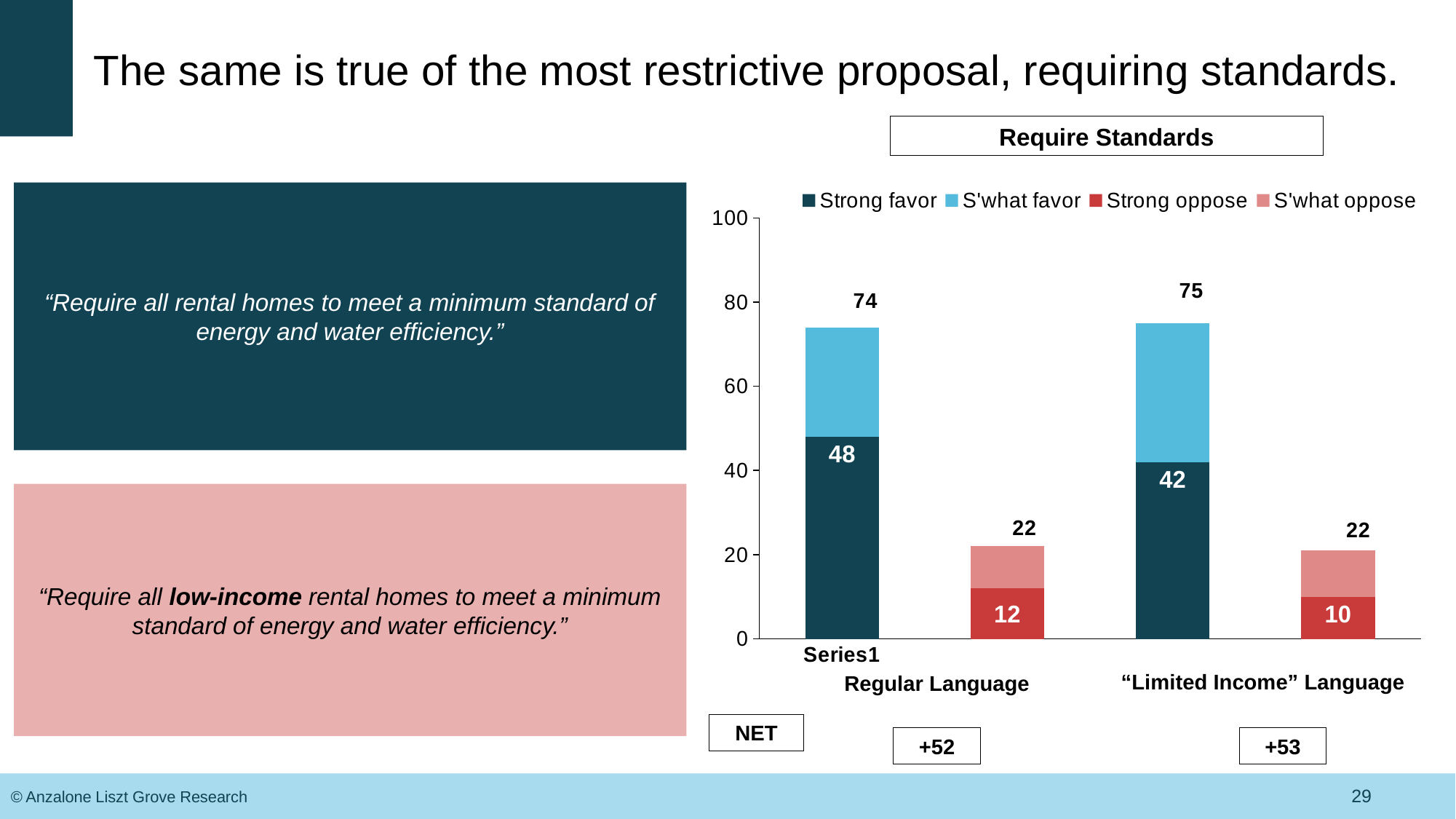
In the "Require Standards" chart, what is the total of the favor bar for "Limited Income" Language? 75 In the "Require Standards" chart, which is larger: the Strong oppose value for Regular Language or for "Limited Income" Language? Regular Language In the "Require Standards" chart, what is the total of the oppose bar for Regular Language? 22 What NET value is shown below the "Limited Income" Language bars in the "Require Standards" chart? +53 In the "Require Standards" chart, what is the total of the favor bar (Strong favor plus S'what favor) for Regular Language? 74 What kind of chart is shown under the "Require Standards" heading? Stacked bar chart In the "Require Standards" chart, what is the Strong oppose value for Regular Language? 12 In the "Require Standards" chart, what is the Strong oppose value for "Limited Income" Language? 10 How many series does the legend of the "Require Standards" chart list? 4 In the "Require Standards" chart, what is the Strong favor value for Regular Language? 48 In the "Require Standards" chart, what is the difference between the Strong favor values for Regular Language and "Limited Income" Language? 6 In the "Require Standards" chart, what is the Strong favor value for "Limited Income" Language? 42